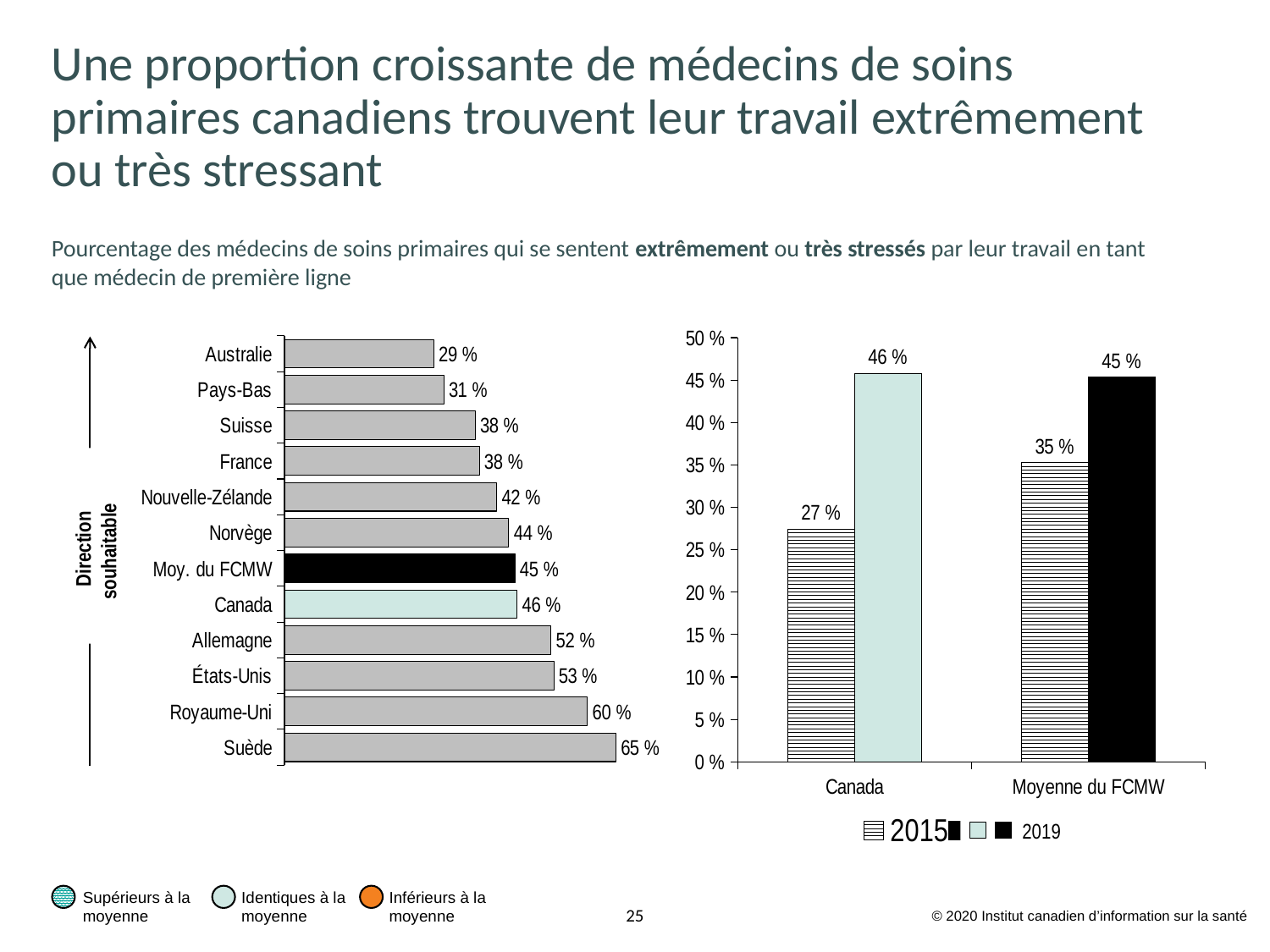
In the right chart, what is the difference between the Canada values for 2019 and 2015? 19 % How many series does the legend of the right chart list? 2 In the left chart, what is the value for Suède? 65 % In the left chart, what is the difference between the values for Royaume-Uni and Pays-Bas? 29 % How many categories are shown in the left chart? 12 In the left chart, which country has the highest value? Suède In the left chart, which country has the lowest value? Australie What type of chart is the left chart? Bar chart In the right chart, what is the value for Canada in 2015? 27 % In the left chart, which is larger, the value for Allemagne or the value for Norvège? Allemagne In the left chart, what is the value for Australie? 29 % In the right chart, what is the value for Moyenne du FCMW in 2019? 45 %